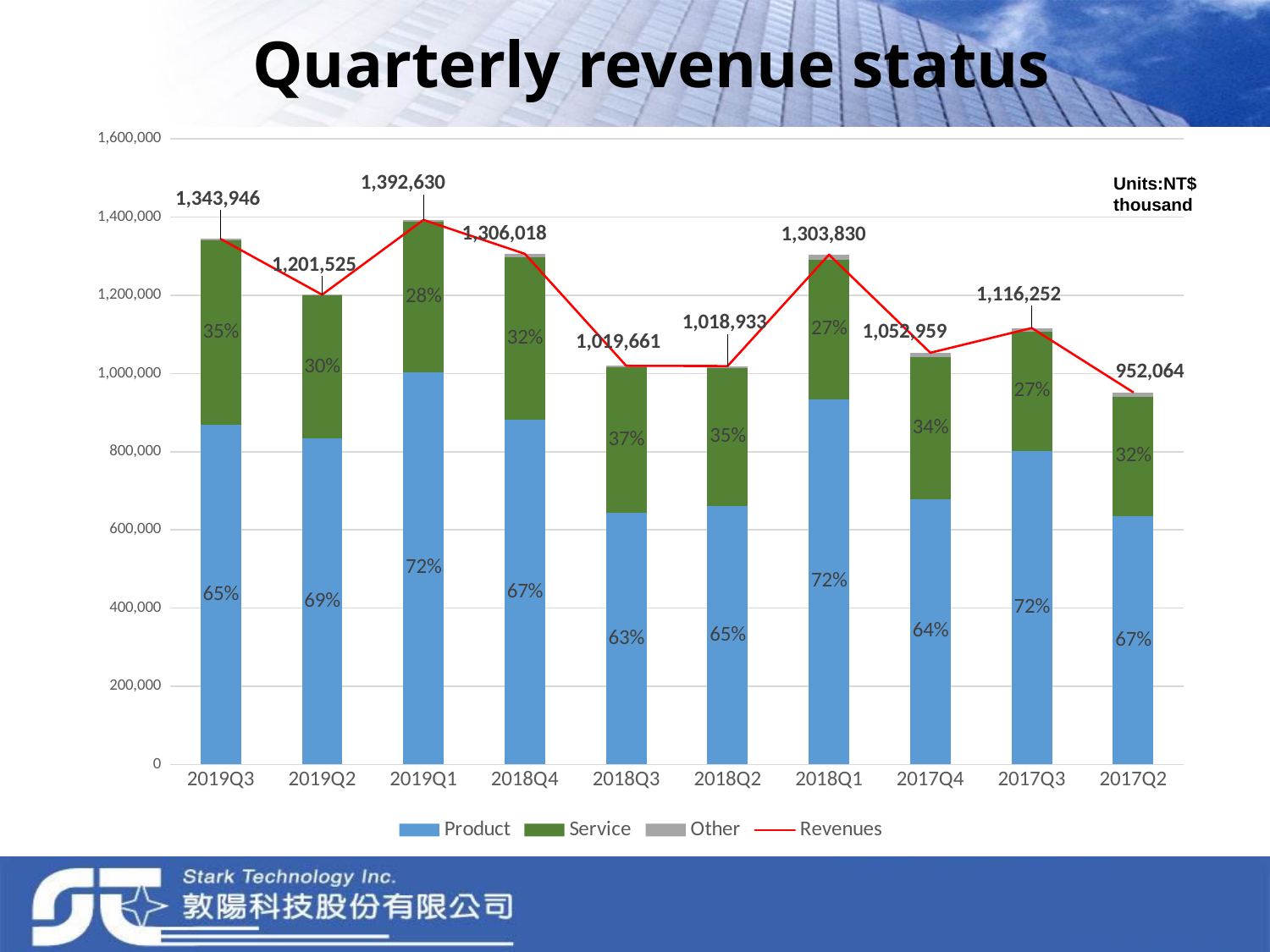
What percentage share does Product have in 2019Q1? 72% What percentage share does Service have in 2018Q3? 37% How many quarters are shown on the x axis? 10 Which quarter has the lowest Revenues value? 2017Q2 Which is larger, the Revenues for 2019Q3 or for 2018Q4? 2019Q3 What is the Revenues value for 2019Q1? 1,392,630 What is the Revenues value for 2017Q2? 952,064 Is the Revenues value for 2017Q4 greater or less than 1,000,000? greater What units are the values in, according to the note on the chart? NT$ thousand How many series does the legend list? 4 What is the difference between the Revenues for 2019Q1 and 2017Q2? 440,566 Which quarter has the highest Revenues value? 2019Q1